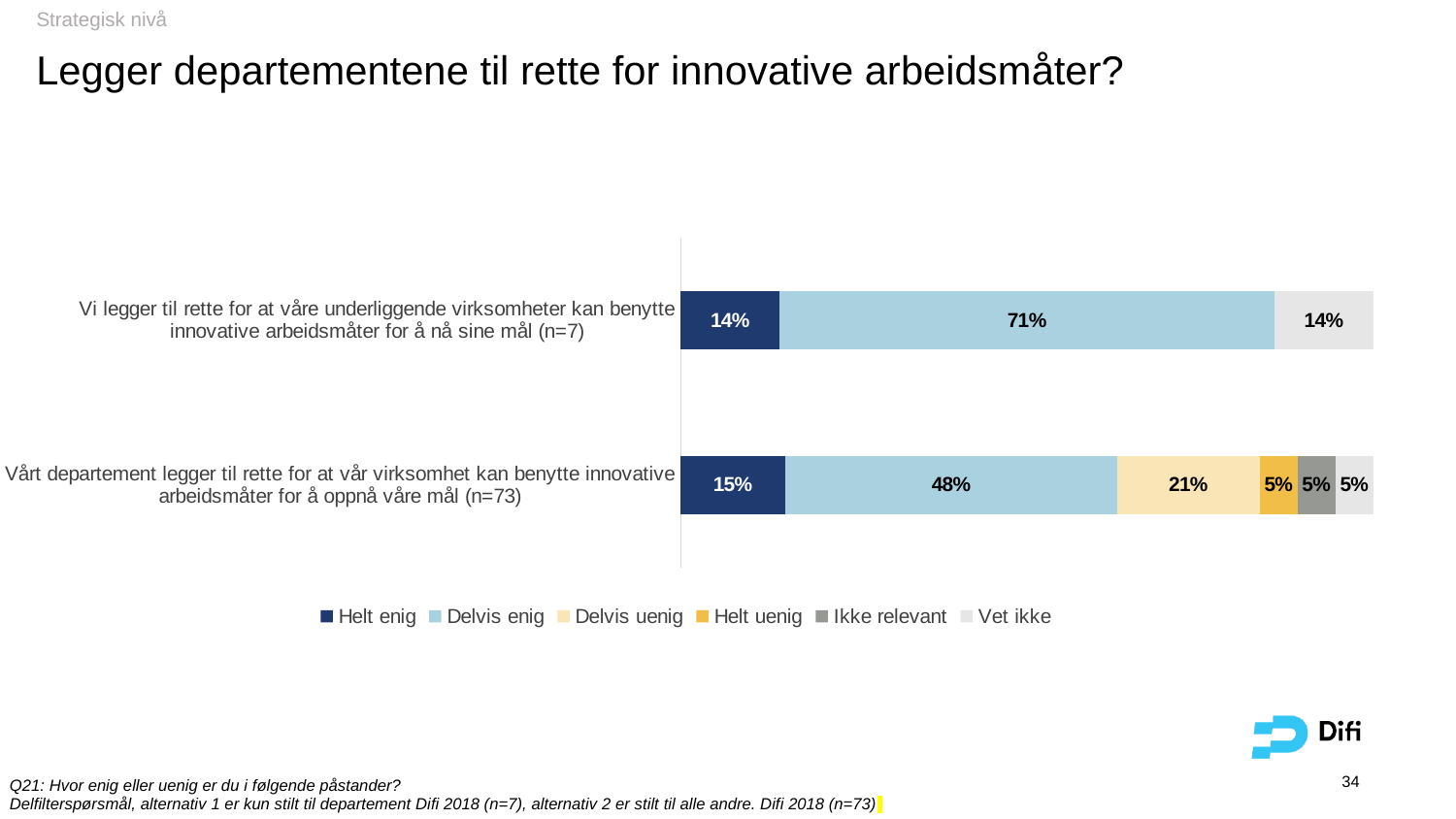
What is the title of the slide containing the chart? Legger departementene til rette for innovative arbeidsmåter? What is the 'Helt uenig' value for the statement with n=73? 5% How many categories (statements) are plotted in the chart? 2 What kind of chart is shown on the slide? Stacked bar chart What is the 'Helt enig' value for the statement 'Vårt departement legger til rette for at vår virksomhet kan benytte innovative arbeidsmåter for å oppnå våre mål (n=73)'? 15% What is the difference between the 'Delvis enig' values for the n=7 statement (71%) and the n=73 statement (48%)? 23 percentage points What is the 'Delvis enig' value for the statement 'Vi legger til rette for at våre underliggende virksomheter kan benytte innovative arbeidsmåter for å nå sine mål (n=7)'? 71% How many series does the legend list? 6 What is the 'Delvis uenig' value for the statement with n=73? 21% Which statement has the higher 'Delvis enig' value, the one with n=7 or the one with n=73? The one with n=7 What is the 'Vet ikke' value for the statement with n=7? 14% Which legend entry is shown in dark blue? Helt enig